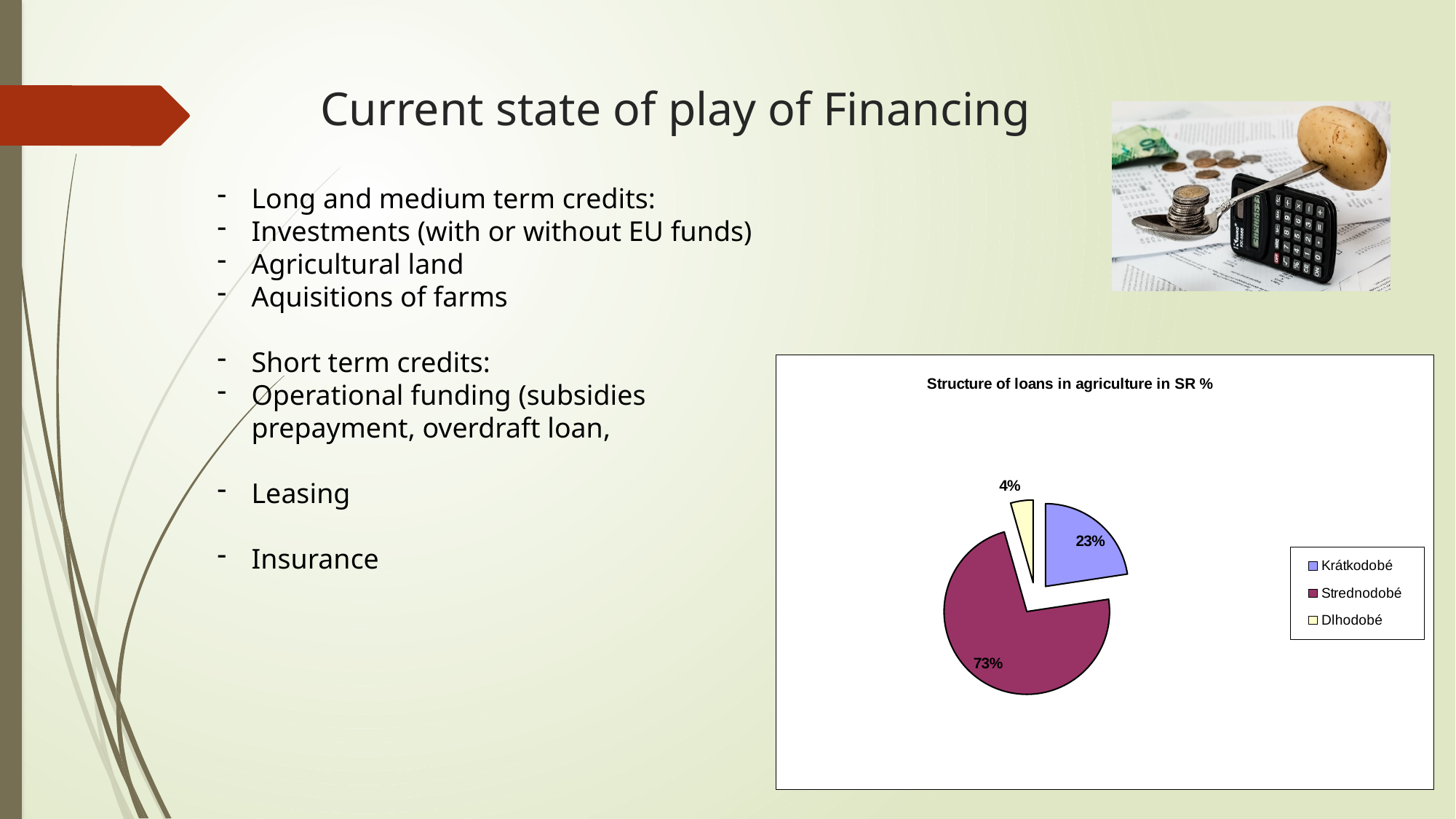
What is the difference in percentage points between Strednodobé and Krátkodobé? 50 What colour is the Strednodobé slice in the pie chart? dark magenta What kind of chart is shown on the slide? pie chart What share of the pie does Dlhodobé have? 4% What share of the pie does Strednodobé have? 73% Which is larger, Krátkodobé or Dlhodobé? Krátkodobé Which category has the smallest slice of the pie? Dlhodobé What share of the pie does Krátkodobé have? 23% Which category has the largest slice of the pie? Strednodobé What is the title of the chart? Structure of loans in agriculture in SR % How many slices does the pie chart have? 3 How many categories does the legend list? 3